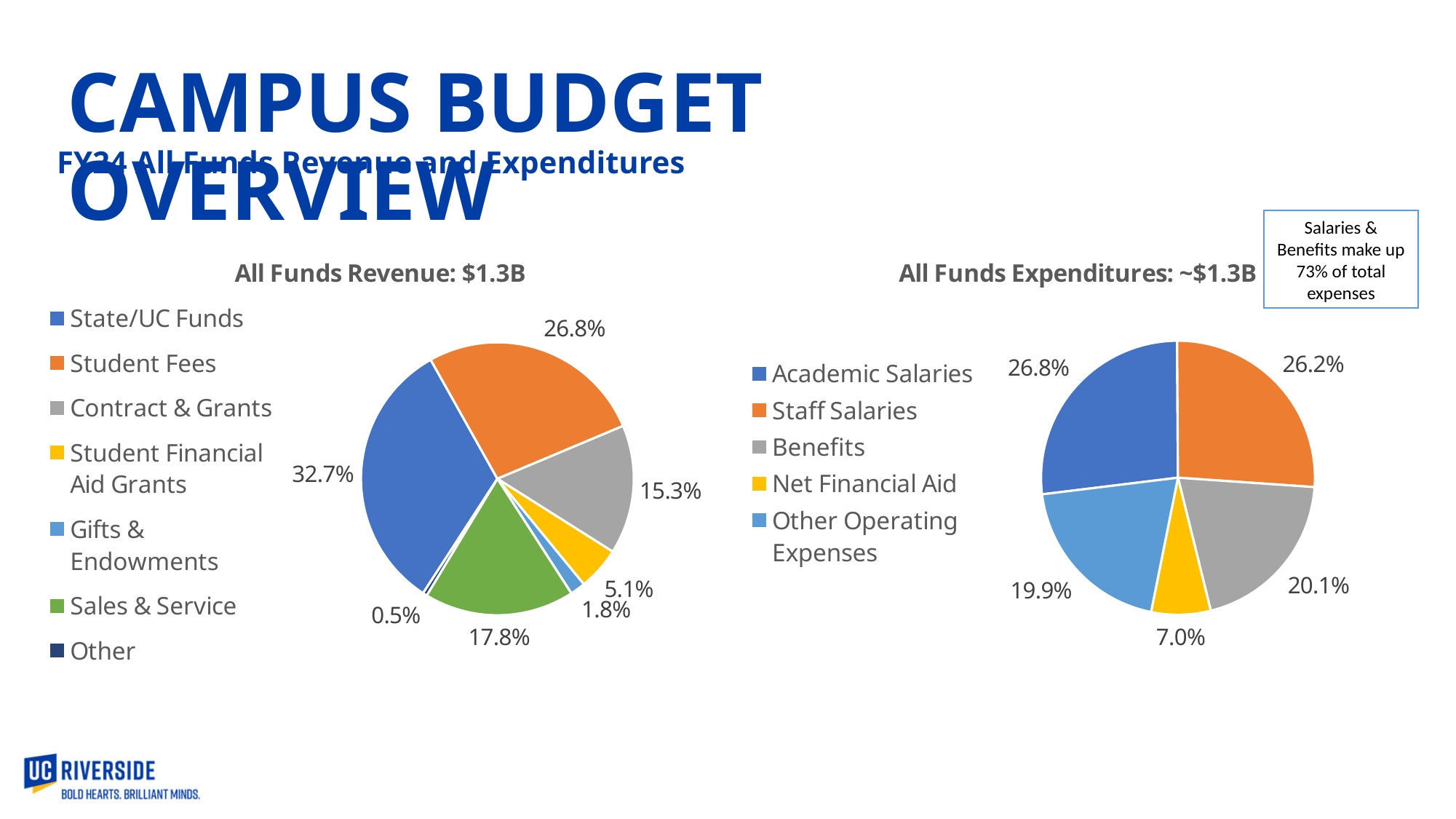
In the All Funds Revenue chart, what is the difference between the Student Fees share and the Contract & Grants share? 11.5% In the All Funds Revenue chart, what share of revenue comes from State/UC Funds? 32.7% In the All Funds Revenue chart, which category has the largest share? State/UC Funds In the All Funds Revenue chart, what percentage is Sales & Service? 17.8% In the All Funds Expenditures chart, what share is Benefits? 20.1% In the All Funds Expenditures chart, which is larger, Staff Salaries or Other Operating Expenses? Staff Salaries In the All Funds Revenue chart, which category has the smallest share? Other In the All Funds Expenditures chart, which category has the largest share? Academic Salaries What type of chart is used for All Funds Expenditures? Pie chart What is the title of the chart on the left side of the slide? All Funds Revenue: $1.3B In the All Funds Expenditures chart, what percentage is Net Financial Aid? 7.0% In the All Funds Revenue chart, how many categories does the legend list? 7